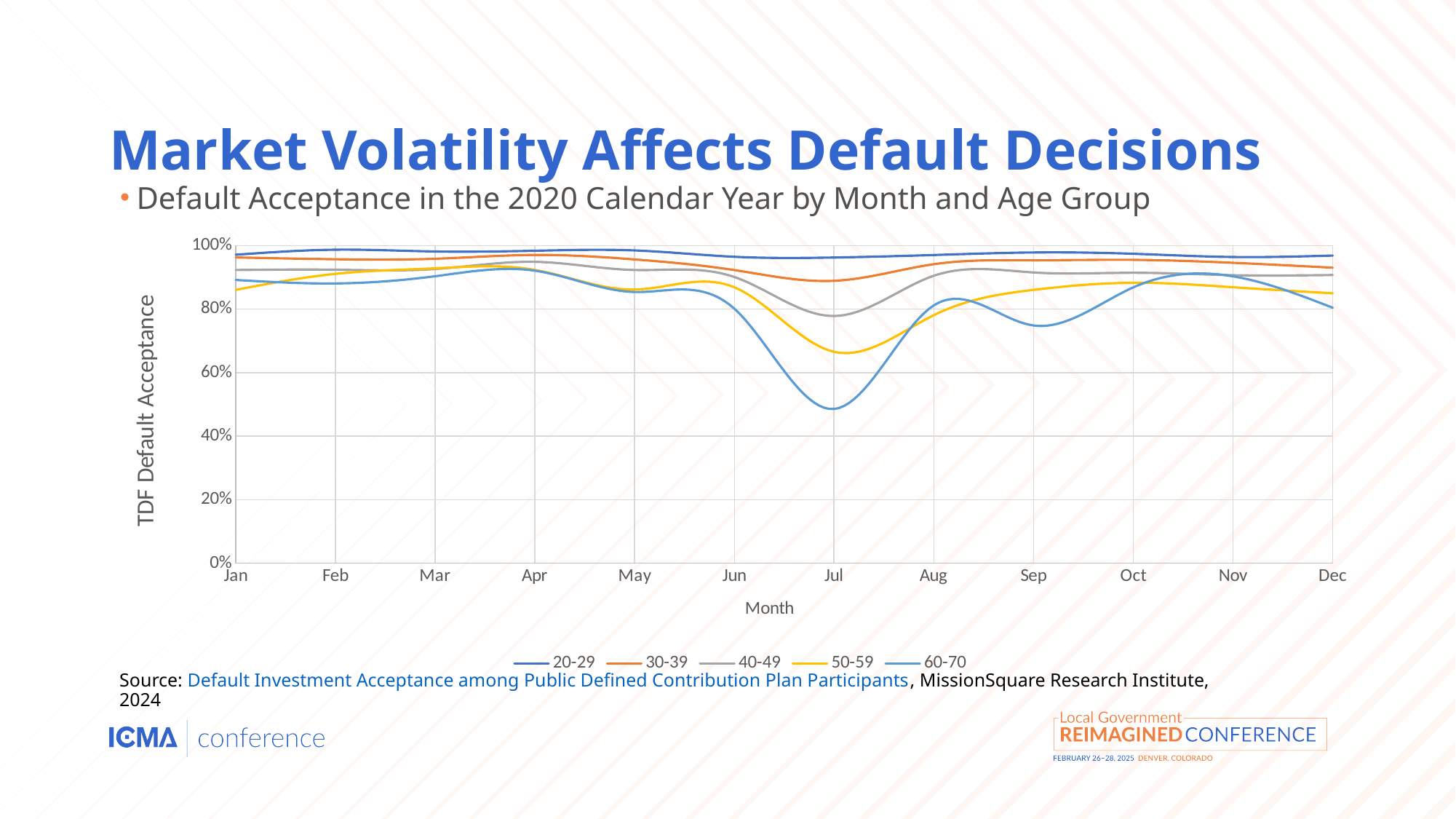
How many age-group series does the legend list? 5 In Jul, which is larger: the value for the 40-49 age group or the 50-59 age group? 40-49 How many months are plotted along the x axis? 12 Is the value for the 50-59 age group in Jul greater or less than 80%? less Does the 60-70 line rise or fall from May to Jul? fall Which age group has the highest TDF default acceptance in Jul? 20-29 In Sep, which is larger: the value for the 20-29 age group or the 60-70 age group? 20-29 Is the value for the 20-29 age group in Jul greater or less than 80%? greater Which age group has the lowest TDF default acceptance in Jul? 60-70 What is the title of the y axis? TDF Default Acceptance Is the value for the 60-70 age group in Jul greater or less than 60%? less What kind of chart is shown on the slide? line chart